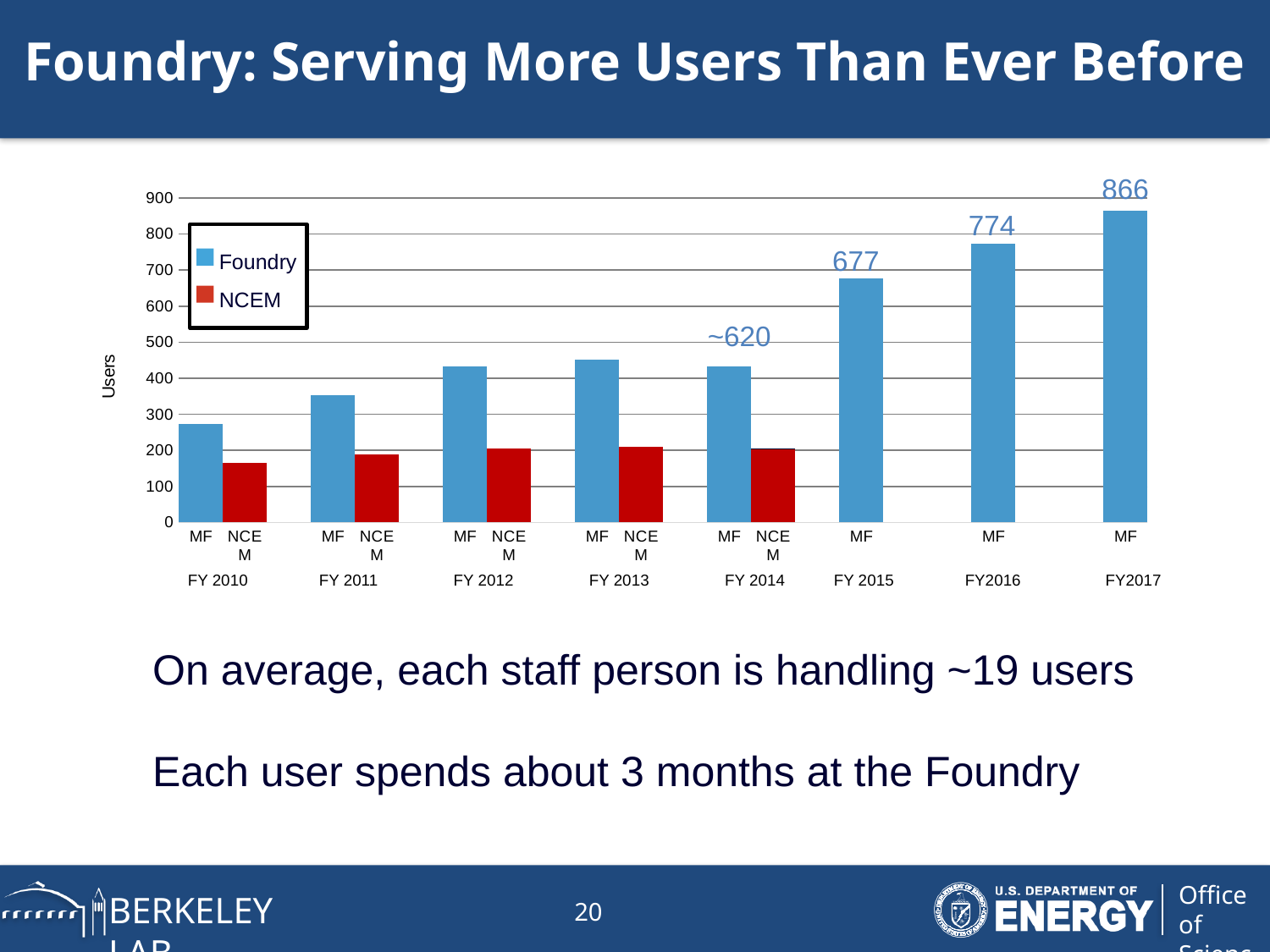
What kind of chart is shown on the slide? bar chart Which fiscal year has the highest Foundry (MF) value? FY2017 What is the Foundry (MF) value for FY 2015? 677 What are the two series named in the chart legend? Foundry and NCEM Is the NCEM value for FY 2010 greater or less than 200? less Which fiscal year has the lowest Foundry (MF) value? FY 2010 What is the difference between the Foundry values for FY2017 and FY2016? 92 What is the Foundry (MF) value for FY2017? 866 How many series does the chart legend list? 2 What is the Foundry (MF) value for FY2016? 774 What is the label on the vertical axis of the chart? Users Is the Foundry (MF) value for FY 2010 greater or less than 300? less